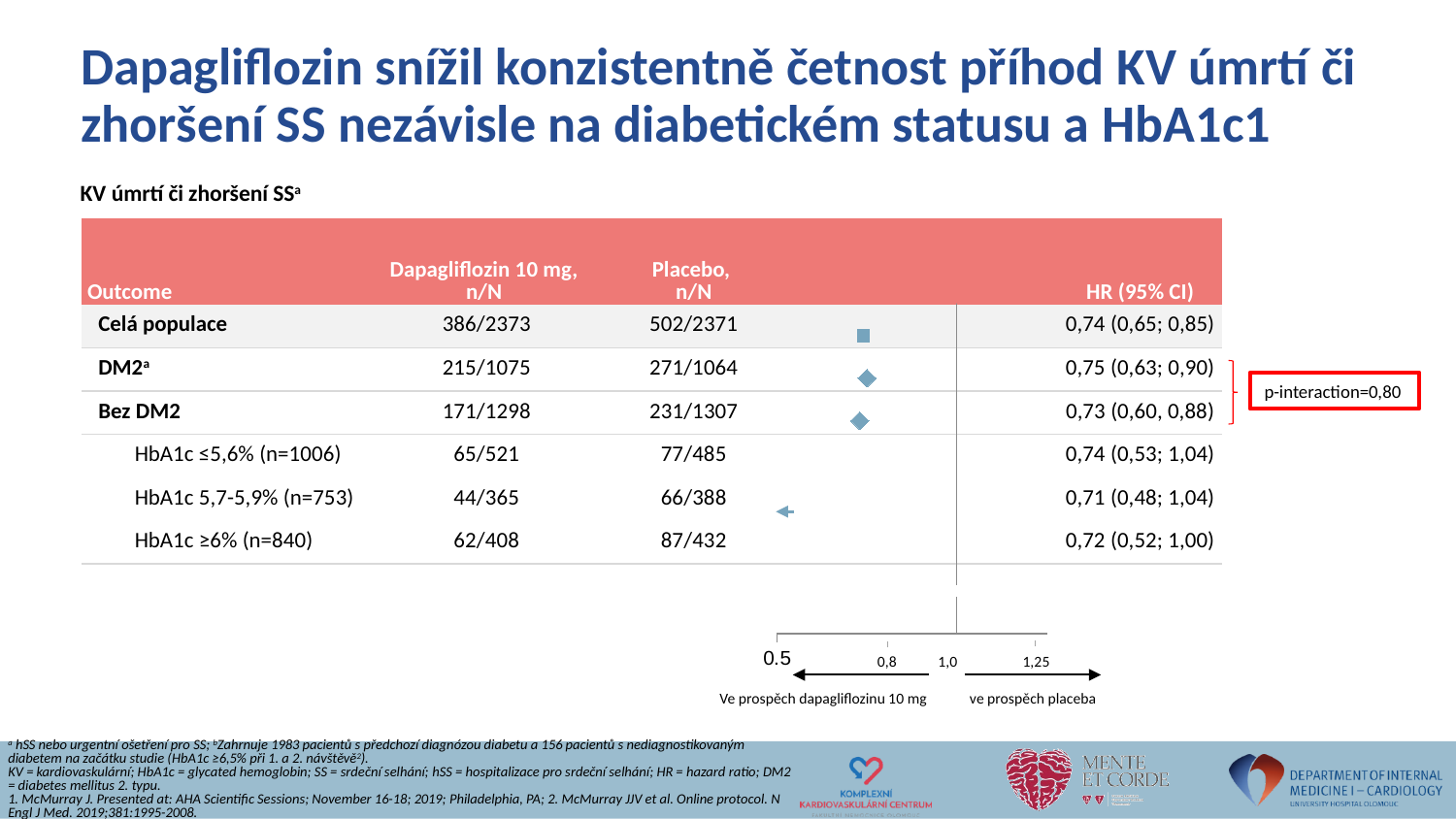
What is the HR (95% CI) for the HbA1c 5,7-5,9% (n=753) subgroup? 0,71 (0,48; 1,04) What is the HR (95% CI) for the DM2 subgroup? 0,75 (0,63; 0,90) What is the HR (95% CI) for Celá populace? 0,74 (0,65; 0,85) Which outcome row has the lowest hazard ratio? HbA1c 5,7-5,9% (n=753) What is the Placebo n/N value for HbA1c ≥6% (n=840)? 87/432 Which outcome row has the highest hazard ratio? DM2 Is the hazard ratio for Celá populace greater or less than 1,0? less What is the Dapagliflozin 10 mg n/N value for Bez DM2? 171/1298 What kind of chart is shown on the slide? Forest plot Which has the larger hazard ratio, DM2 or Bez DM2? DM2 What is the p-interaction value shown between the DM2 and Bez DM2 rows? p-interaction=0,80